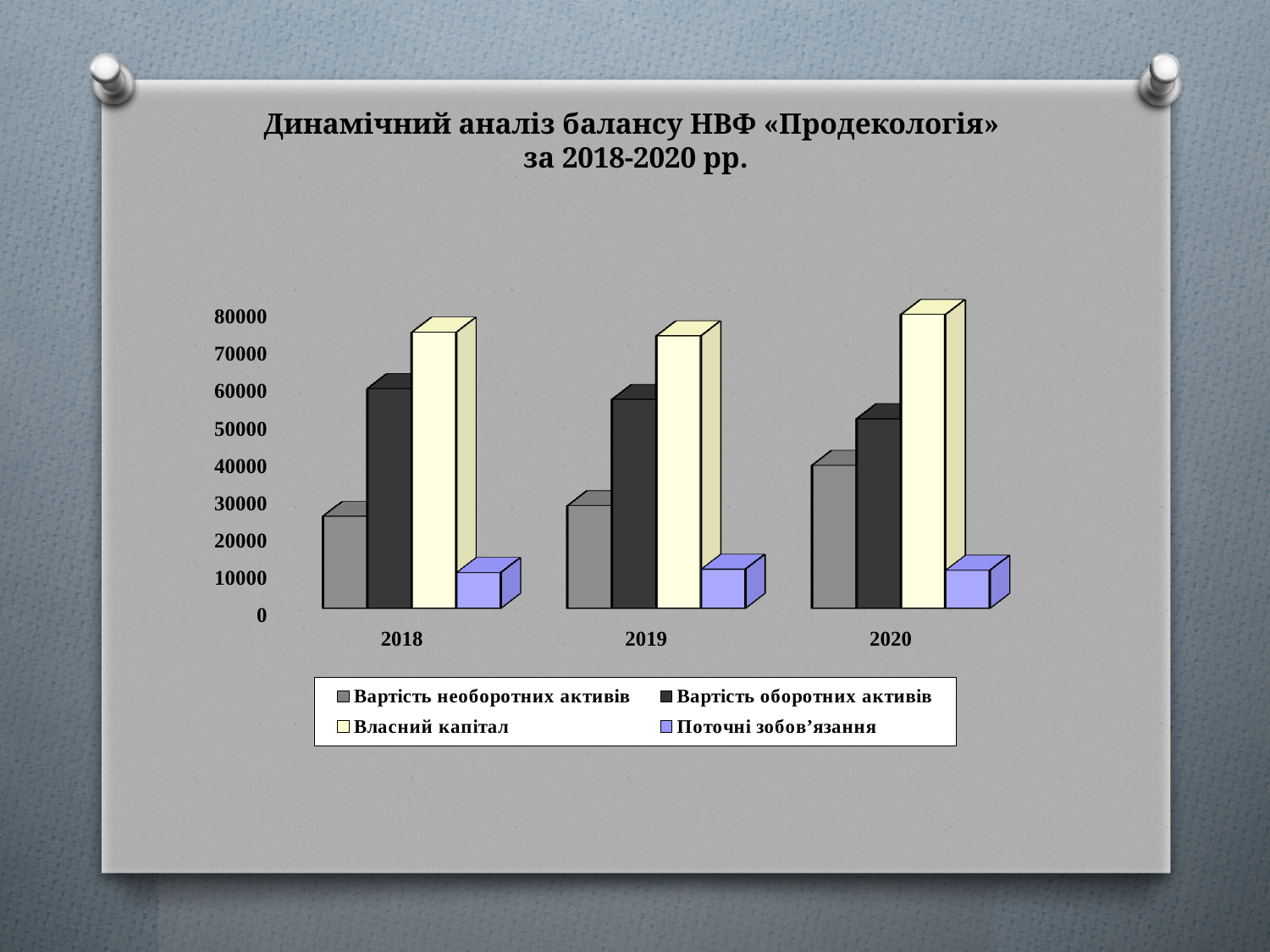
Is the value of Вартість необоротних активів in 2020 greater or less than 30000? greater In which year is Вартість необоротних активів the highest? 2020 Does Вартість необоротних активів rise or fall from 2018 to 2020? rise How many series does the legend list? 4 What is the title of the chart? Динамічний аналіз балансу НВФ «Продекологія» за 2018-2020 рр. Is the value of Поточні зобов’язання in 2019 greater or less than 20000? less Which series has the highest value in 2018? Власний капітал How many years (categories) are shown on the x axis? 3 What kind of chart is shown on the slide? bar chart Which series has the lowest value in 2020? Поточні зобов’язання Is the value of Власний капітал in 2018 greater or less than 70000? greater Which is larger: Вартість оборотних активів in 2018 or in 2020? 2018